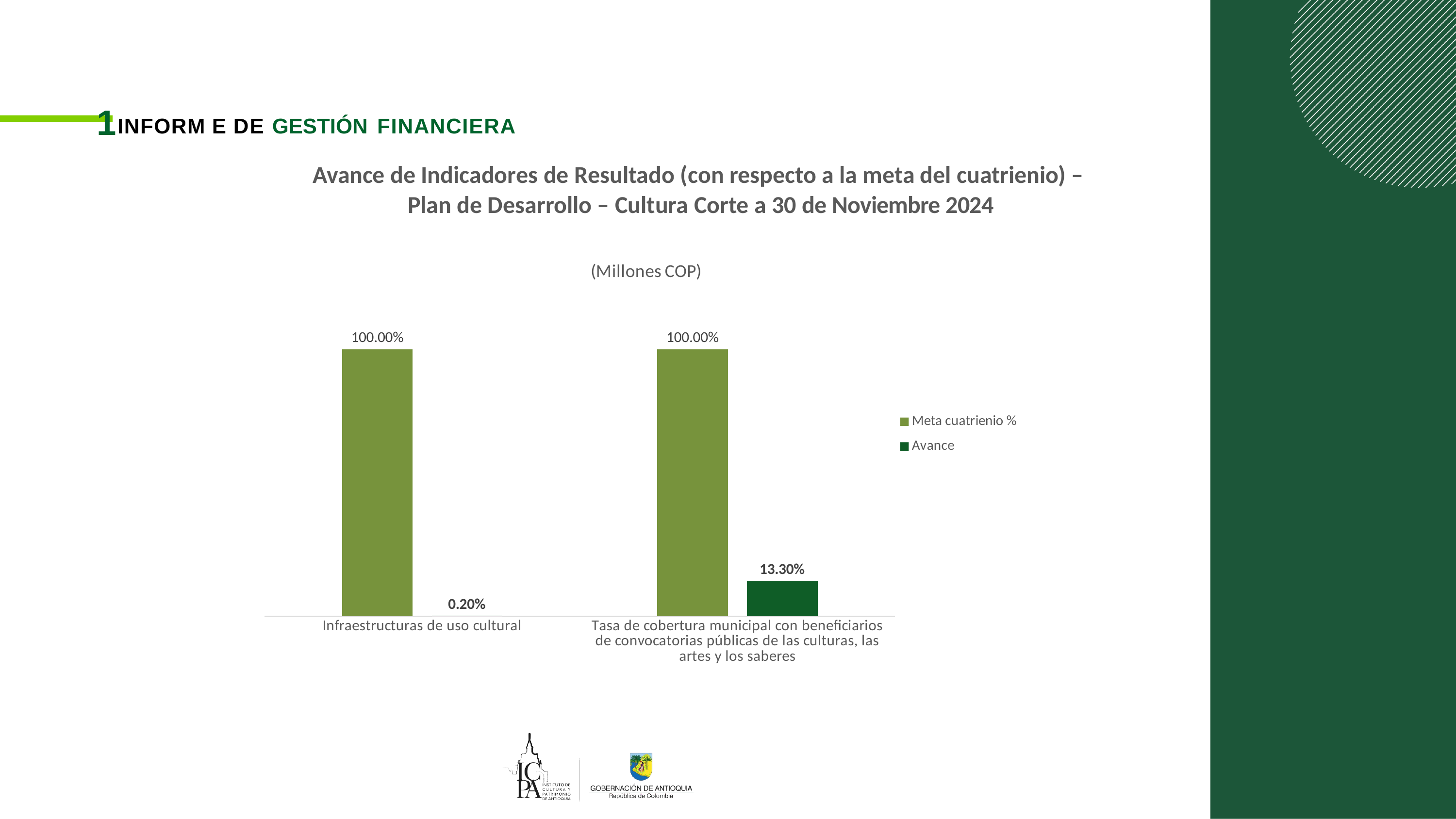
What is the Meta cuatrienio % value for Infraestructuras de uso cultural? 100.00% What is the Avance value for Infraestructuras de uso cultural? 0.20% Which category has the higher Avance value? Tasa de cobertura municipal con beneficiarios de convocatorias públicas de las culturas, las artes y los saberes What is the Meta cuatrienio % value for Tasa de cobertura municipal con beneficiarios de convocatorias públicas de las culturas, las artes y los saberes? 100.00% What is the Avance value for Tasa de cobertura municipal con beneficiarios de convocatorias públicas de las culturas, las artes y los saberes? 13.30% Which category has the lower Avance value? Infraestructuras de uso cultural How many categories are shown on the x axis? 2 What kind of chart is shown on the slide? bar chart How many series does the legend list? 2 For Tasa de cobertura municipal, what is the difference between Meta cuatrienio % and Avance? 86.70% Is the Avance for Infraestructuras de uso cultural larger or smaller than the Avance for Tasa de cobertura municipal? smaller What is the difference between the Avance values of the two categories? 13.10%